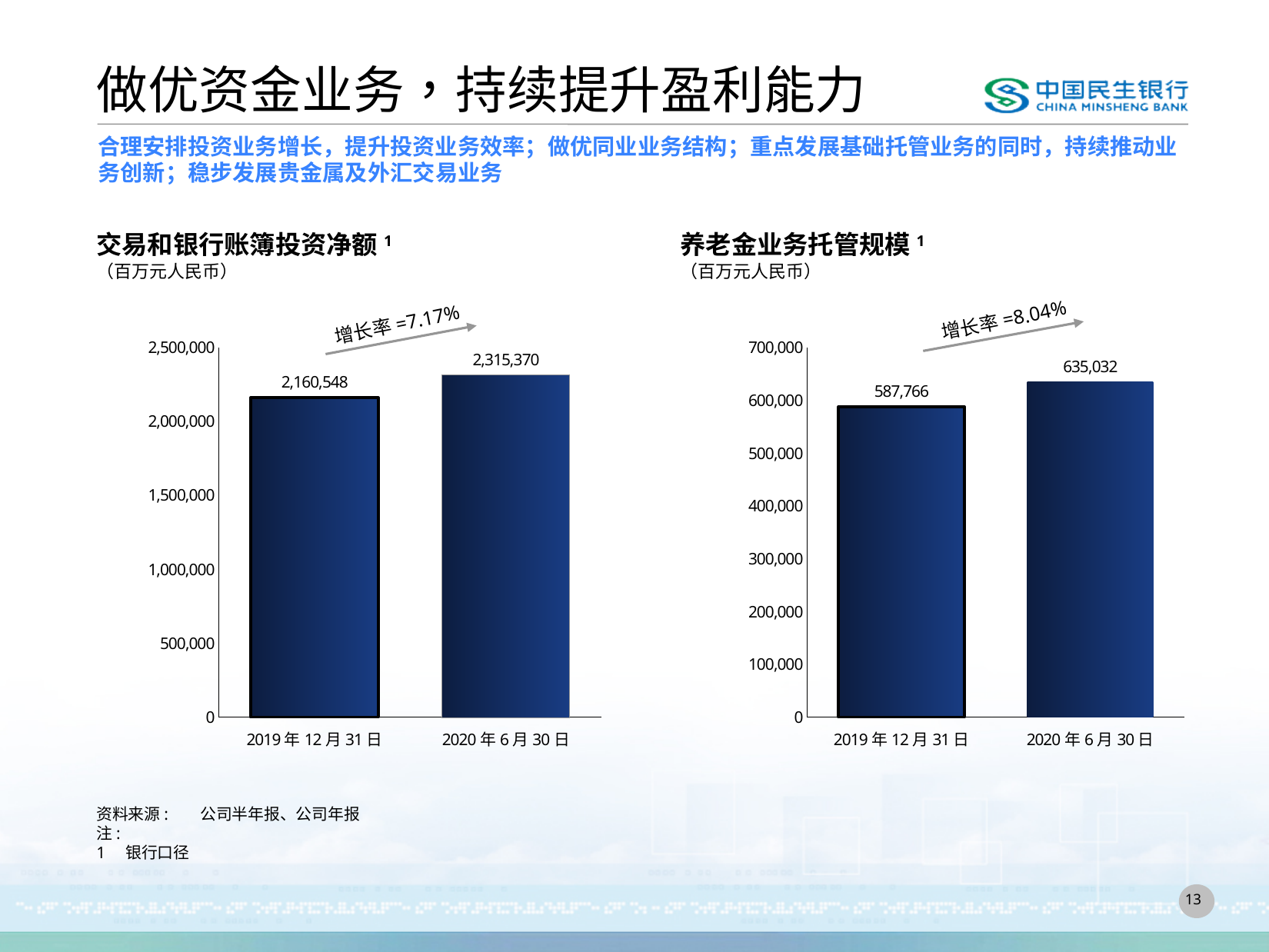
What kind of chart is the right chart (养老金业务托管规模)? bar chart In the right chart (养老金业务托管规模), what is the value for 2019年12月31日? 587,766 In the left chart (交易和银行账簿投资净额), what is the value for 2020年6月30日? 2,315,370 How many bars are shown in the left chart (交易和银行账簿投资净额)? 2 In the right chart (养老金业务托管规模), what is the difference between the 2020年6月30日 value and the 2019年12月31日 value? 47,266 In the left chart (交易和银行账簿投资净额), what is the value for 2019年12月31日? 2,160,548 In the right chart (养老金业务托管规模), which date has the higher value? 2020年6月30日 In the left chart (交易和银行账簿投资净额), do the values rise or fall from 2019年12月31日 to 2020年6月30日? rise In the left chart (交易和银行账簿投资净额), what is the difference between the 2020年6月30日 value and the 2019年12月31日 value? 154,822 In the right chart (养老金业务托管规模), what is the value for 2020年6月30日? 635,032 In the left chart (交易和银行账簿投资净额), which date has the lower value? 2019年12月31日 What growth rate (增长率) is annotated on the right chart (养老金业务托管规模)? 8.04%